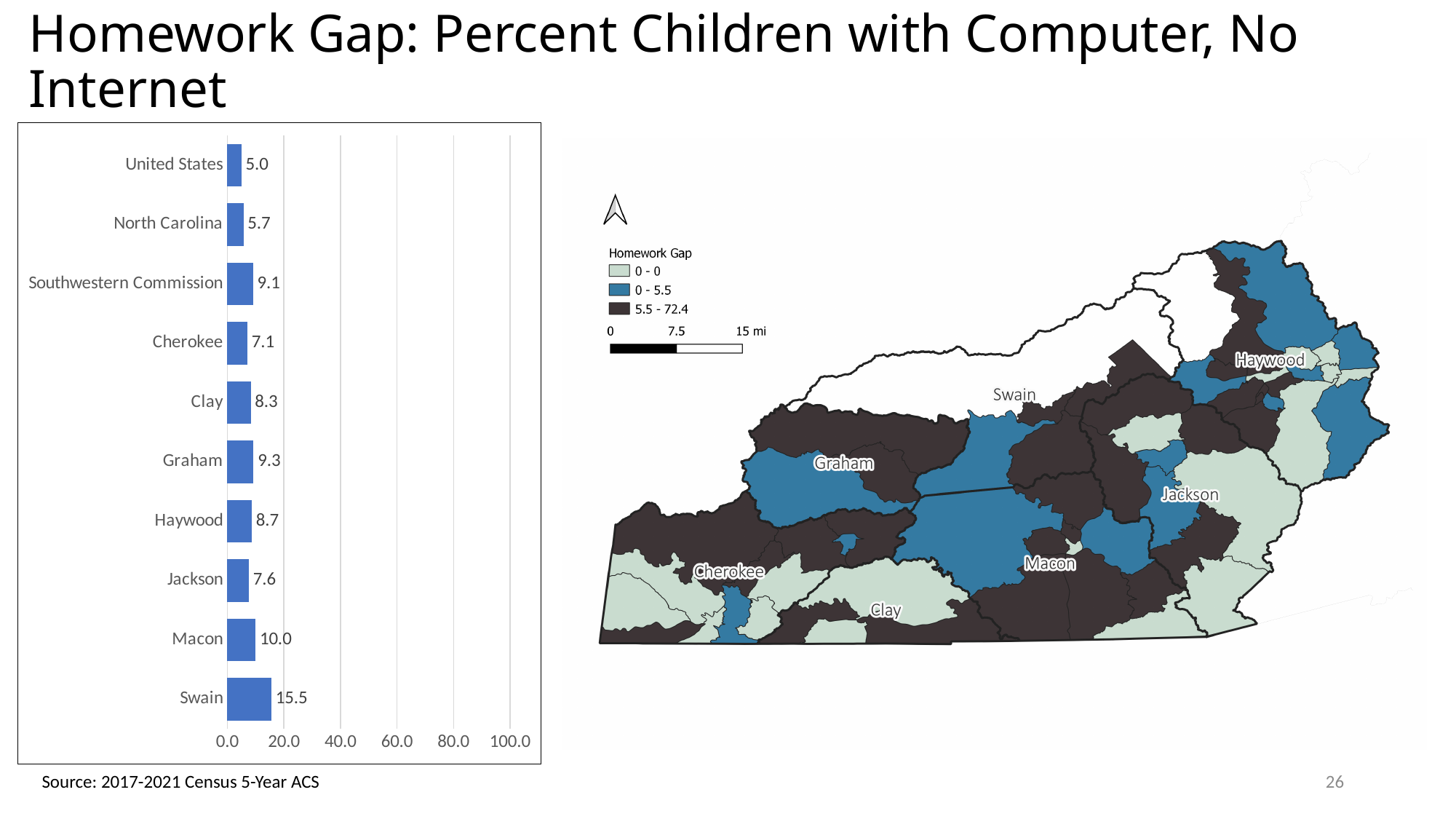
What is the highest value shown on the x axis of the bar chart? 100.0 Which has a larger value in the bar chart, Clay or Jackson? Clay Is the value for Macon in the bar chart greater or less than 20.0? less What kind of chart is shown on the left of the slide? bar chart What is the difference between the values for Graham and Cherokee in the bar chart? 2.2 Which category has the lowest value in the bar chart? United States How many categories are shown in the bar chart? 10 Which category has the highest value in the bar chart? Swain What is the value for Swain in the bar chart? 15.5 What is the value for Southwestern Commission in the bar chart? 9.1 What is the value for North Carolina in the bar chart? 5.7 What is the difference between the values for Swain and Macon in the bar chart? 5.5